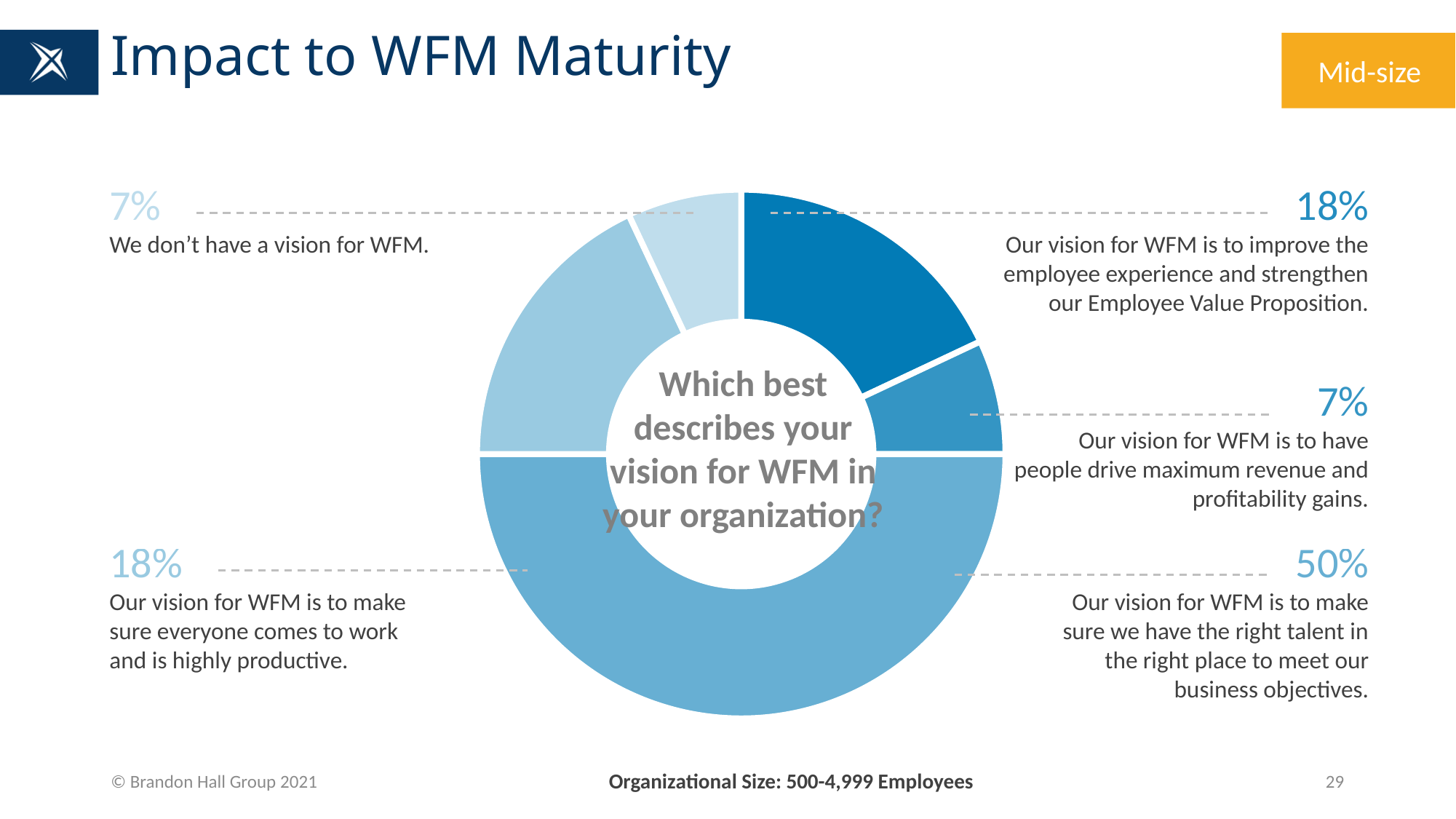
What organizational size does the chart cover, according to the footer? 500-4,999 Employees What type of chart is shown on the slide? Donut (pie) chart How many response categories are shown in the chart? 5 Which is larger: the share for 'improve the employee experience' or the share for 'drive maximum revenue and profitability gains'? Improve the employee experience (18%) What is the smallest percentage shown on the chart? 7% What percentage of respondents said they don't have a vision for WFM? 7% What percentage said their vision for WFM is to have people drive maximum revenue and profitability gains? 7% How many percentage points larger is the 'right talent in the right place' response than the 'make sure everyone comes to work and is highly productive' response? 32 percentage points Which response has the largest share of the chart? Our vision for WFM is to make sure we have the right talent in the right place to meet our business objectives. What percentage of respondents said their vision for WFM is to make sure they have the right talent in the right place to meet business objectives? 50% What percentage said their vision for WFM is to improve the employee experience and strengthen the Employee Value Proposition? 18% What question is written in the center of the chart? Which best describes your vision for WFM in your organization?